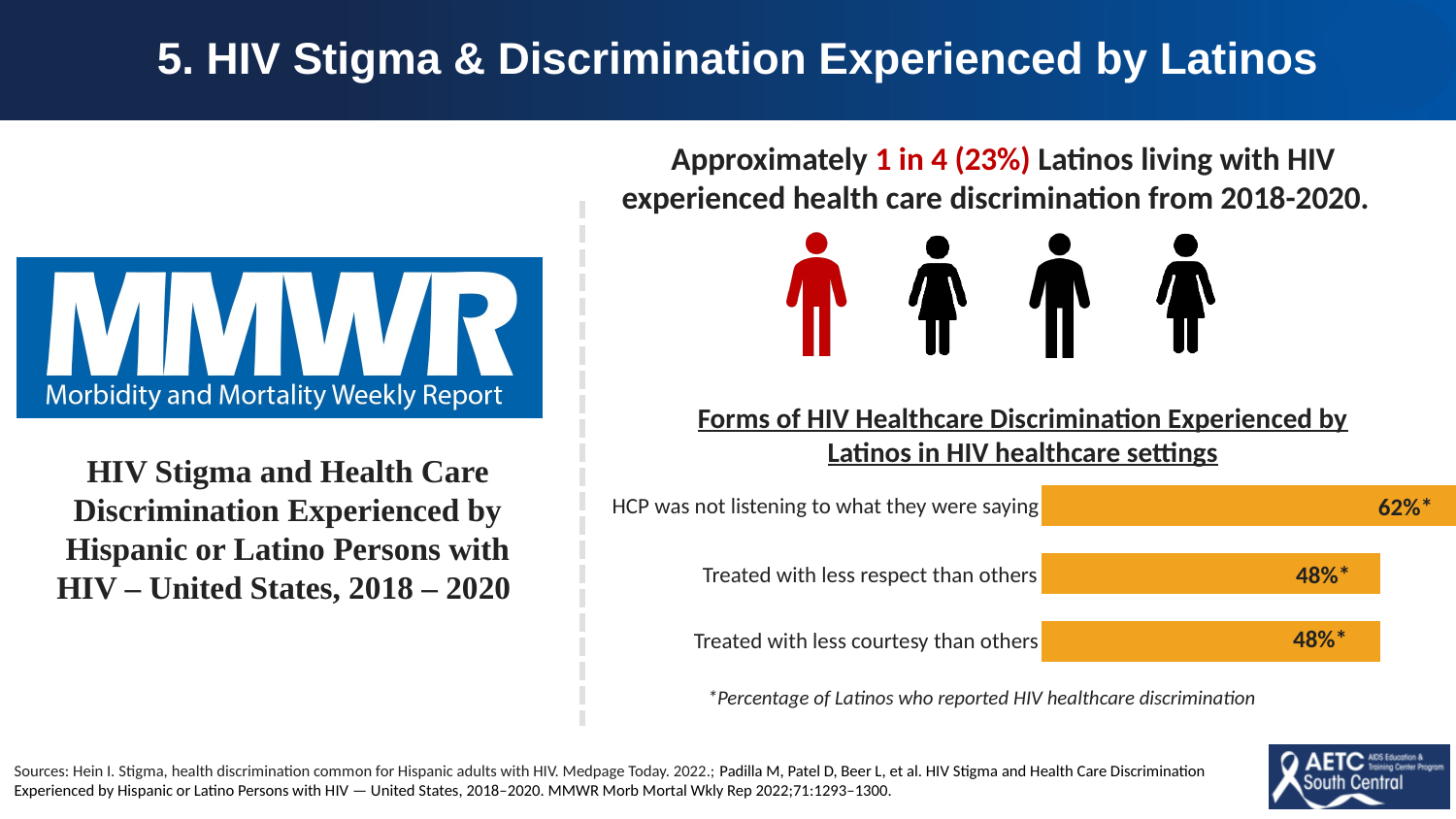
According to the slide, approximately what fraction of Latinos living with HIV experienced health care discrimination from 2018-2020? 1 in 4 (23%) Do 'Treated with less respect than others' and 'Treated with less courtesy than others' have the same percentage? Yes, both 48% Which form of HIV healthcare discrimination has the highest percentage in the chart? HCP was not listening to what they were saying What is the difference in percentage points between 'HCP was not listening to what they were saying' and 'Treated with less respect than others'? 14 percentage points How many forms of discrimination are shown as bars in the chart? 3 What is the title of the chart on the slide? Forms of HIV Healthcare Discrimination Experienced by Latinos in HIV healthcare settings What percentage of Latinos reported being treated with less courtesy than others? 48% What percentage of Latinos reported that the HCP was not listening to what they were saying? 62% What type of chart is used to show the forms of HIV healthcare discrimination? Bar chart What colour are the bars in the chart? Orange What percentage of Latinos reported being treated with less respect than others? 48% Which is larger: the percentage for 'HCP was not listening to what they were saying' or for 'Treated with less courtesy than others'? HCP was not listening to what they were saying